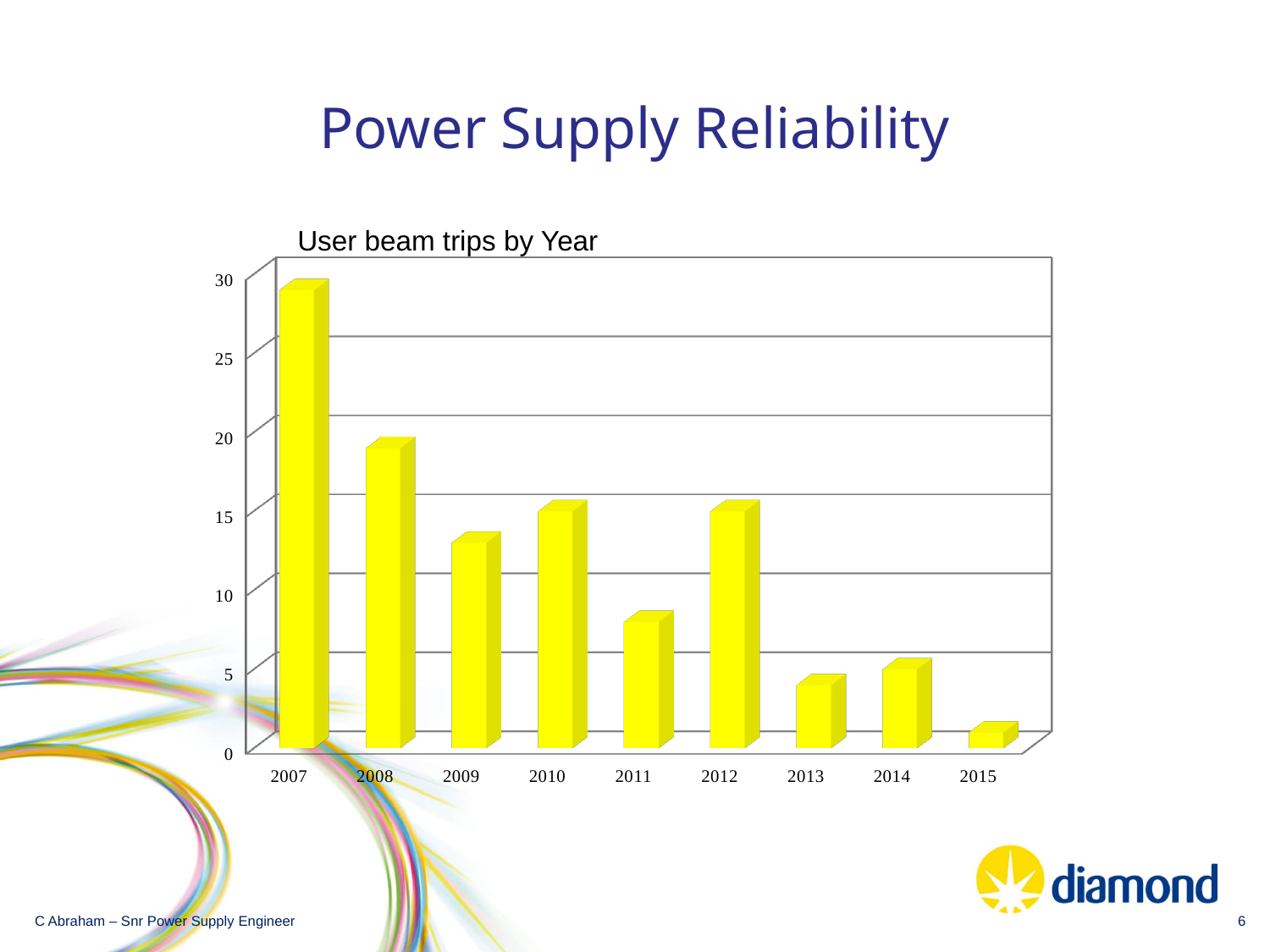
Which year has more user beam trips, 2011 or 2012? 2012 Is the value for 2015 greater or less than 5? less Is the value for 2011 greater or less than 10? less Which year has the highest number of user beam trips? 2007 Is the value for 2009 greater or less than 10? greater What is the title of the chart? User beam trips by Year Which year has the lowest number of user beam trips? 2015 How many years are shown on the x axis of the chart? 9 Which year has more user beam trips, 2008 or 2009? 2008 What kind of chart is shown on the slide? Bar chart Do user beam trips generally rise or fall from 2007 to 2015? Fall